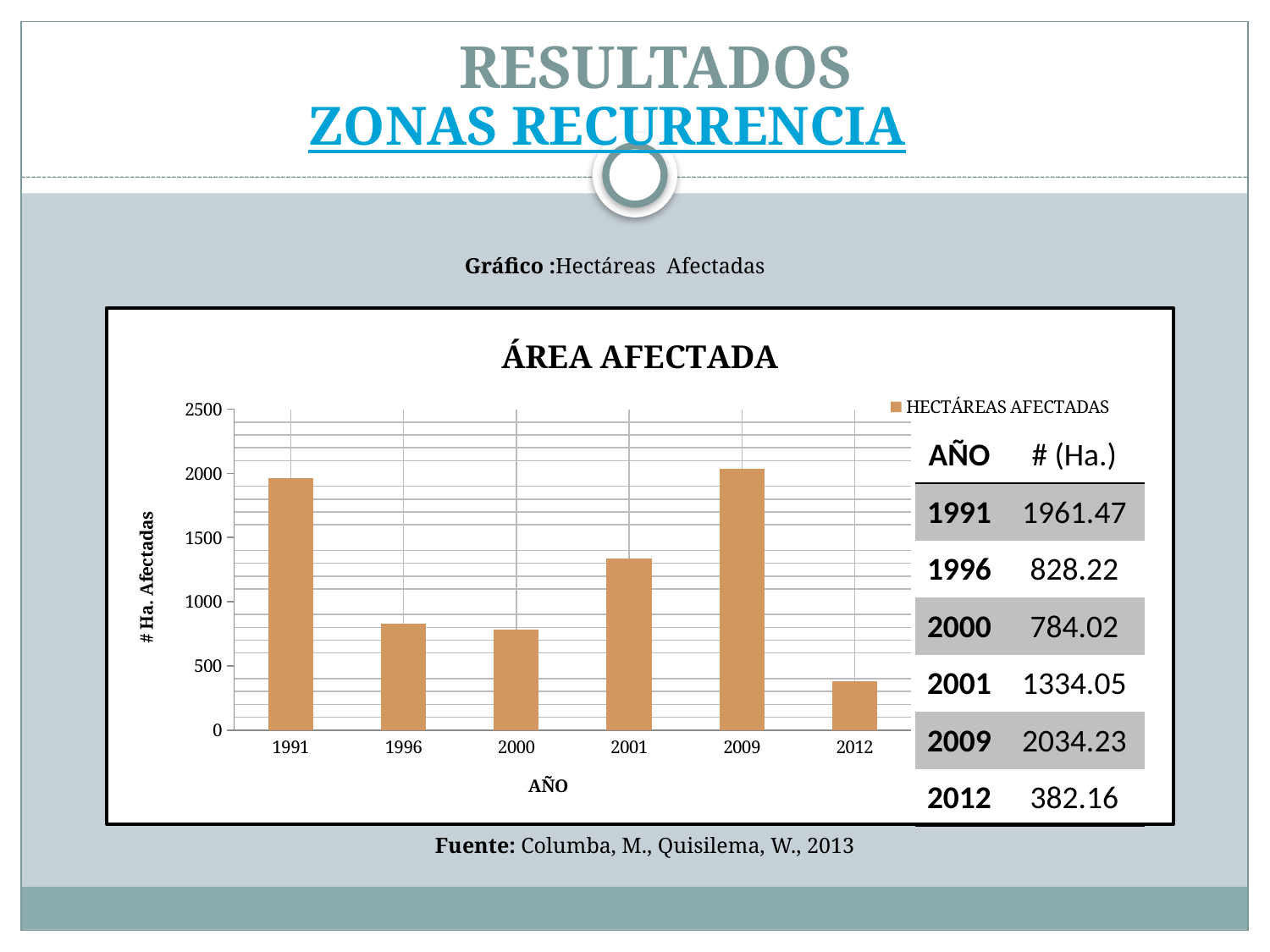
Is the value for 2001 greater or less than 1000? greater What is the value of hectáreas afectadas for 1991? 1961.47 How many years are plotted on the x axis of the chart? 6 What is the difference between the hectáreas afectadas in 2009 and in 1991? 72.76 Which year has more hectáreas afectadas, 2001 or 1996? 2001 Which year has the highest number of hectáreas afectadas? 2009 How many series does the chart legend list? 1 Which year has the lowest number of hectáreas afectadas? 2012 What is the value of hectáreas afectadas for 2012? 382.16 What is the title of the chart? ÁREA AFECTADA What type of chart is shown on the slide? bar chart What is the label of the y axis of the chart? # Ha. Afectadas